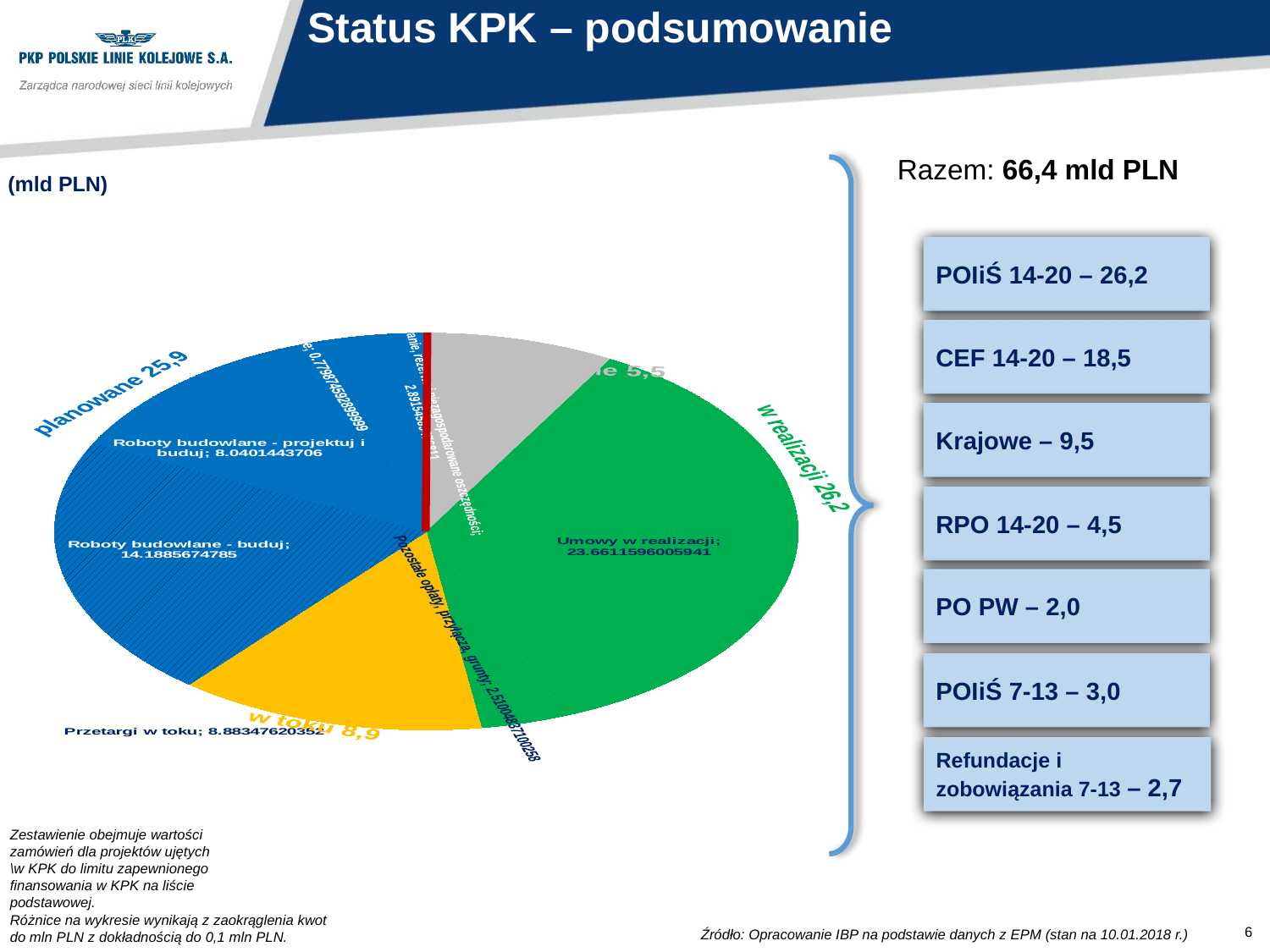
What kind of chart is shown on the slide? pie chart What value is shown for the slice "Roboty budowlane - projektuj i buduj"? 8.0401443706 What value is shown for the slice "Umowy w realizacji"? 23.6611596005941 What colour is the "Umowy w realizacji" slice? green Which is larger: "Roboty budowlane - buduj" or "Roboty budowlane - projektuj i buduj"? Roboty budowlane - buduj What total is given for the "planowane" group annotated on the pie chart? 25,9 What is the difference between the values for "Roboty budowlane - buduj" and "Roboty budowlane - projektuj i buduj"? 6.1484231079 What unit is stated for the values in the pie chart? mld PLN Which slice of the pie chart is the largest? Umowy w realizacji Which is larger: "Umowy w realizacji" or "Roboty budowlane - buduj"? Umowy w realizacji What value is shown for the slice "Roboty budowlane - buduj"? 14.1885674785 What total is given for the "w realizacji" group annotated on the pie chart? 26,2